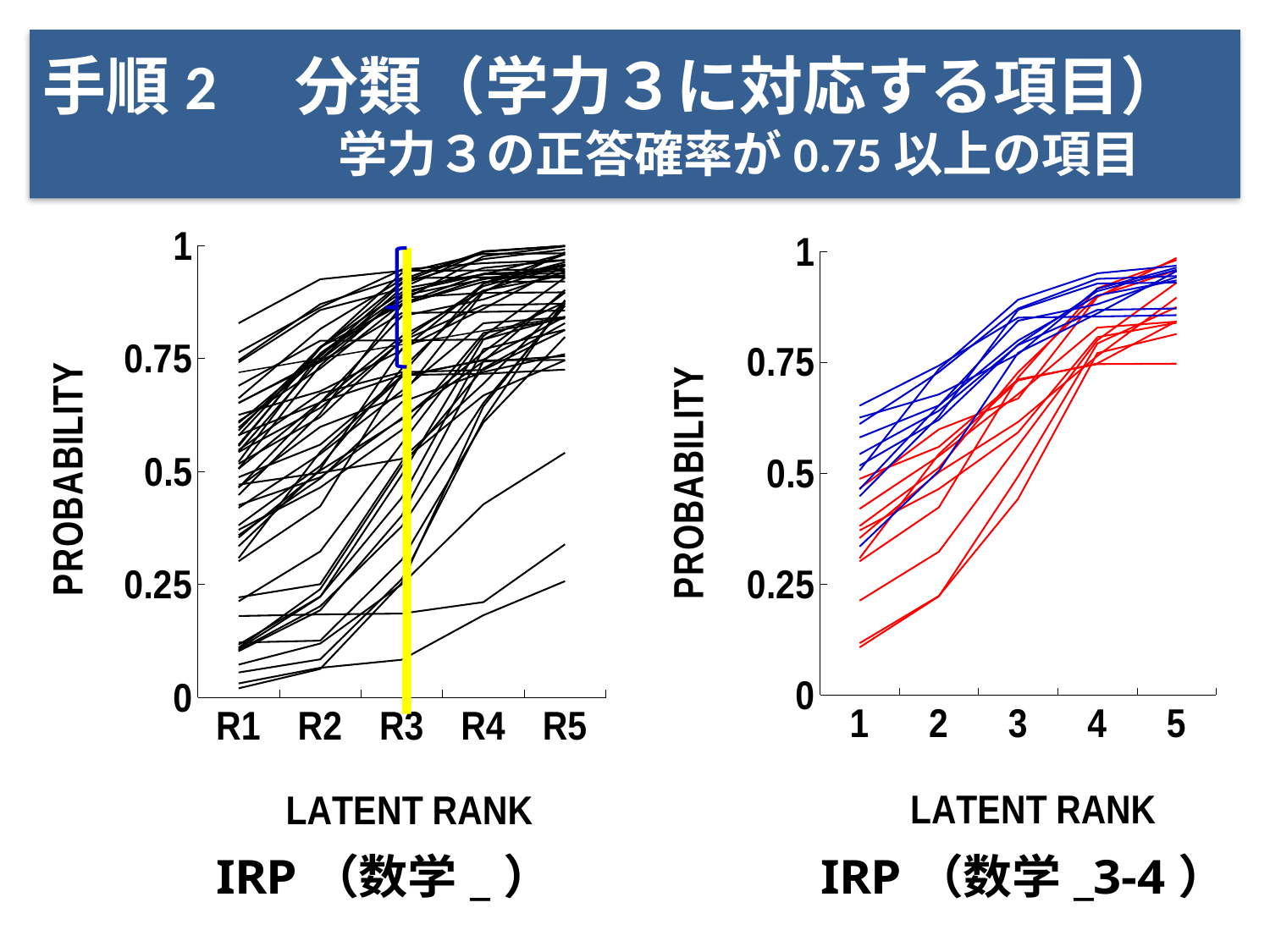
In the right chart, IRP (数学_3-4), do the lines generally rise or fall from latent rank 1 to 5? rise In the left chart, IRP (数学_), at which latent rank is the vertical yellow line drawn? R3 In the left chart, IRP (数学_), do the lines generally rise or fall from R1 to R5? rise In the right chart, IRP (数学_3-4), are all the lines at latent rank 5 greater or less than 0.5? greater In the left chart, IRP (数学_), what is the highest tick value on the y axis? 1 In the left chart, IRP (数学_), how many latent rank categories are shown on the x axis? 5 In the right chart, IRP (数学_3-4), what two colours are the lines drawn in? blue and red What kind of chart is the left chart, IRP (数学_)? line chart What kind of chart is the right chart, IRP (数学_3-4)? line chart In the right chart, IRP (数学_3-4), is the lowest line at latent rank 1 greater or less than 0.25? less In the right chart, IRP (数学_3-4), how many latent rank points are shown on the x axis? 5